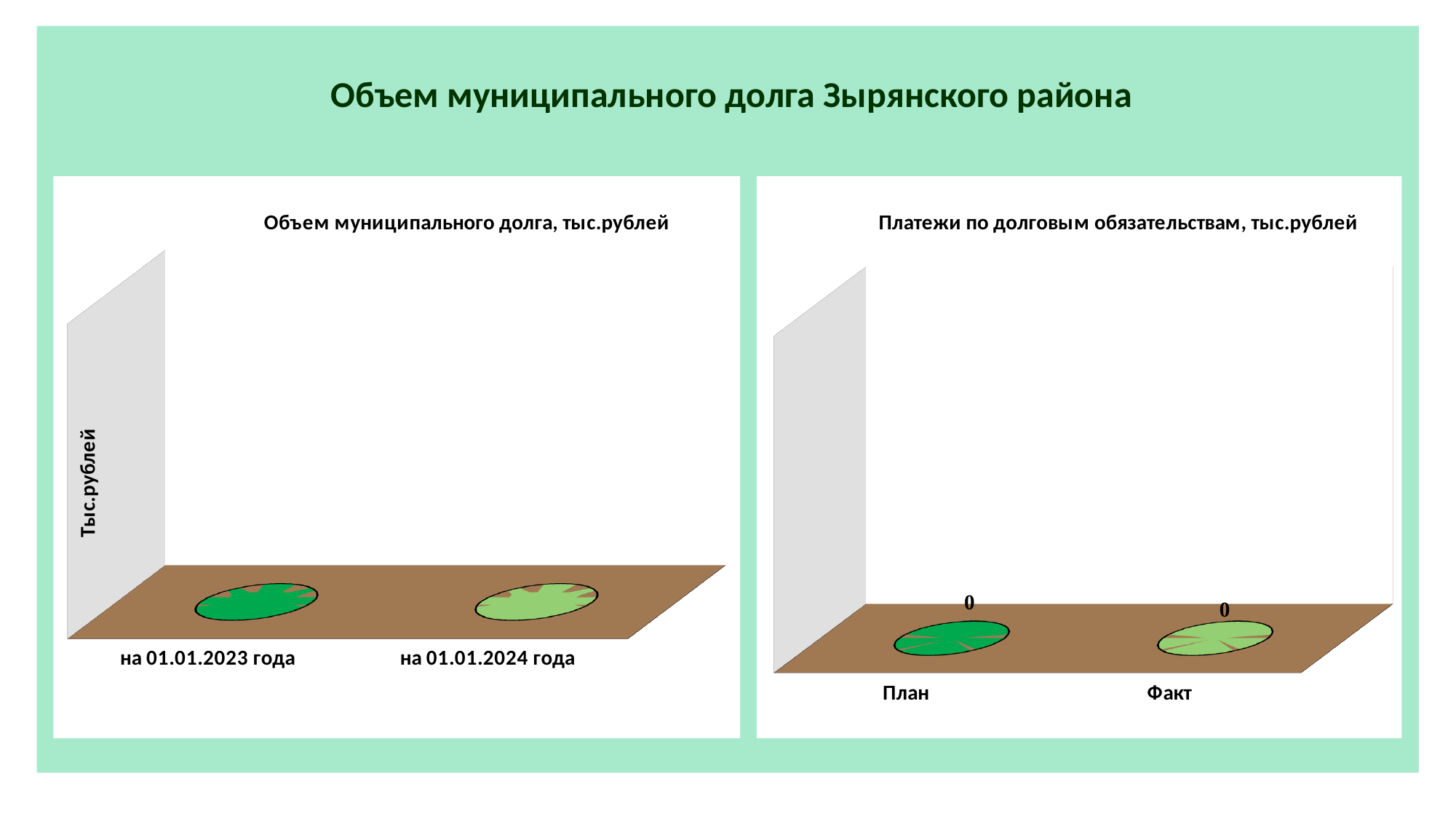
How many categories are shown in the chart titled "Платежи по долговым обязательствам, тыс.рублей"? 2 How many categories are shown in the chart titled "Объем муниципального долга, тыс.рублей"? 2 In the chart titled "Платежи по долговым обязательствам, тыс.рублей", what is the difference between the План and Факт values? 0 What are the category labels on the x axis of the chart titled "Объем муниципального долга, тыс.рублей"? на 01.01.2023 года, на 01.01.2024 года In the chart titled "Платежи по долговым обязательствам, тыс.рублей", what is the value for Факт? 0 What is the vertical axis title of the chart on the left side of the slide? Тыс.рублей What kind of chart is the one titled "Объем муниципального долга, тыс.рублей"? Bar chart What kind of chart is the one titled "Платежи по долговым обязательствам, тыс.рублей"? Bar chart In the chart titled "Платежи по долговым обязательствам, тыс.рублей", what is the value for План? 0